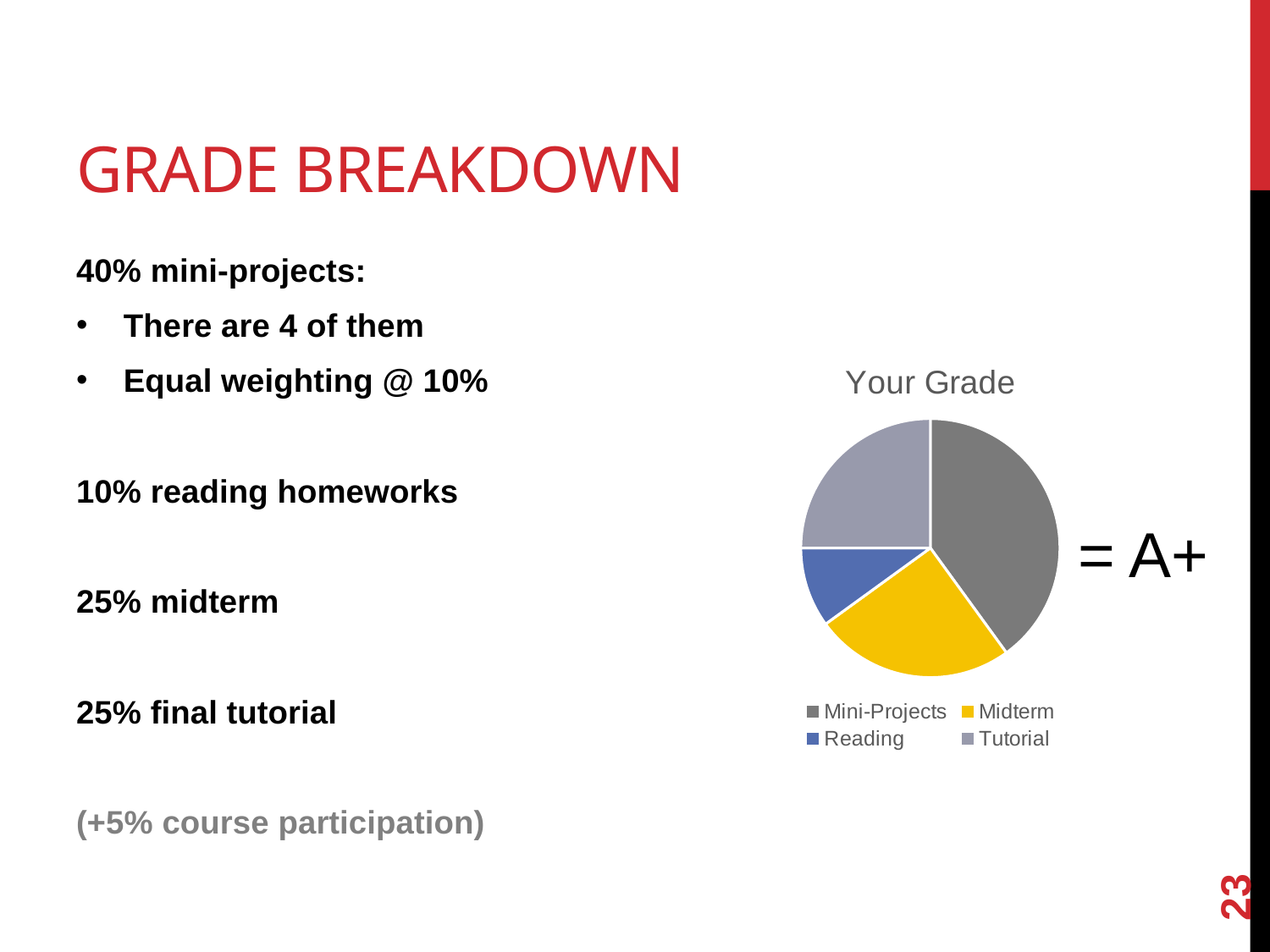
In the "Your Grade" pie chart, which is larger: the Mini-Projects slice or the Midterm slice? Mini-Projects How many entries does the legend of the "Your Grade" pie chart list? 4 Which legend entry in the "Your Grade" pie chart is shown in yellow? Midterm How many slices does the "Your Grade" pie chart have? 4 What is the title of the pie chart? Your Grade In the "Your Grade" pie chart, which is larger: the Reading slice or the Tutorial slice? Tutorial What kind of chart is shown under the title "Your Grade"? pie chart In the "Your Grade" pie chart, which is larger: the Midterm slice or the Reading slice? Midterm Which slice of the "Your Grade" pie chart is the largest? Mini-Projects Which slice of the "Your Grade" pie chart is the smallest? Reading